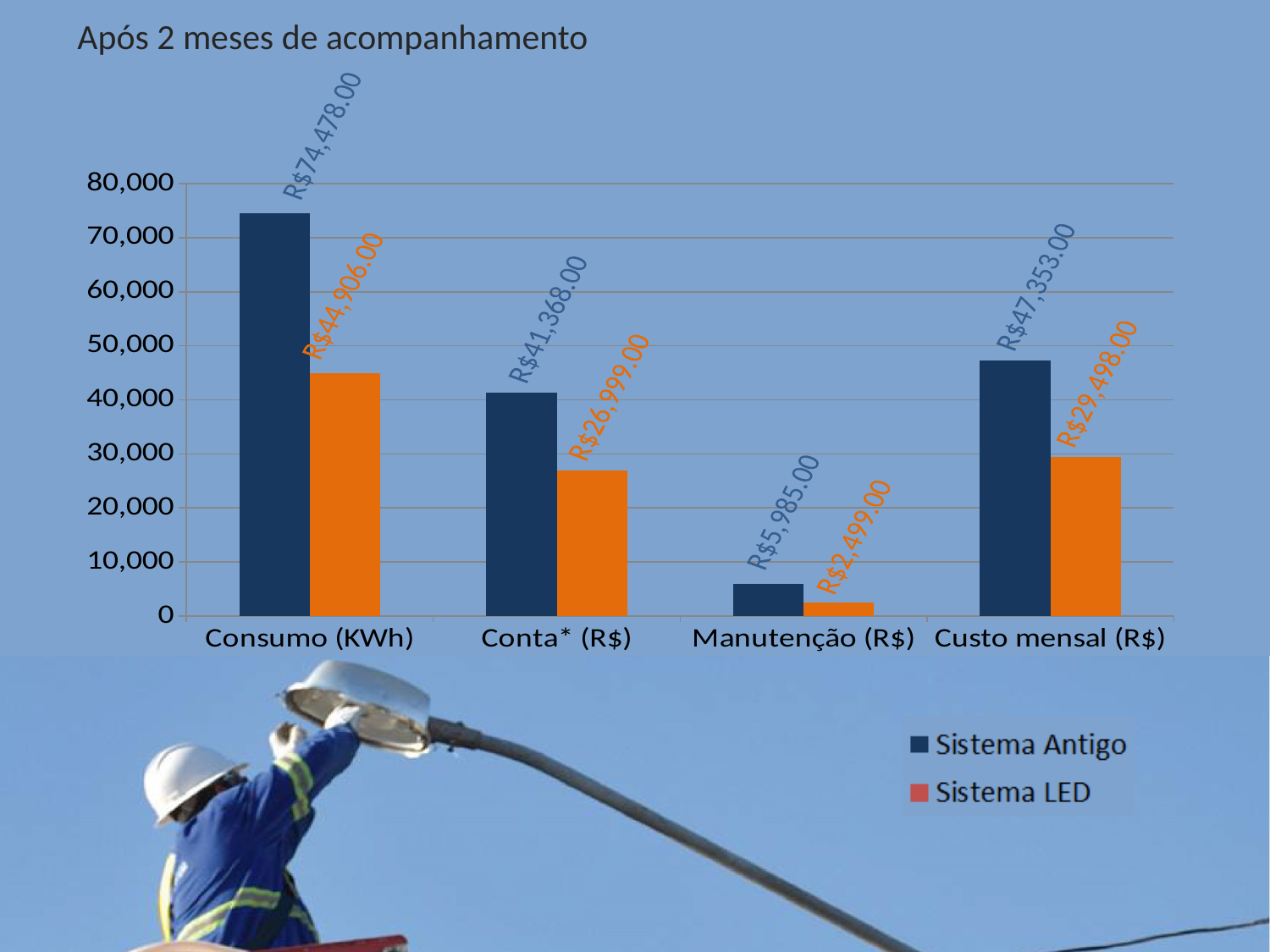
What is the difference between Sistema Antigo and Sistema LED in the Custo mensal (R$) category? R$17,855.00 Is the value for Sistema LED in the Consumo (KWh) category greater or less than 40,000? greater Which category has the highest value for Sistema Antigo? Consumo (KWh) What is the value for Sistema Antigo in the Consumo (KWh) category? R$74,478.00 How many series does the legend list? 2 Which is larger in the Conta* (R$) category: Sistema Antigo or Sistema LED? Sistema Antigo What is the value for Sistema LED in the Custo mensal (R$) category? R$29,498.00 What is the value for Sistema Antigo in the Manutenção (R$) category? R$5,985.00 What kind of chart is shown on the slide? Bar chart How many categories are shown on the x axis? 4 Which category has the lowest value for Sistema LED? Manutenção (R$) What is the value for Sistema LED in the Conta* (R$) category? R$26,999.00